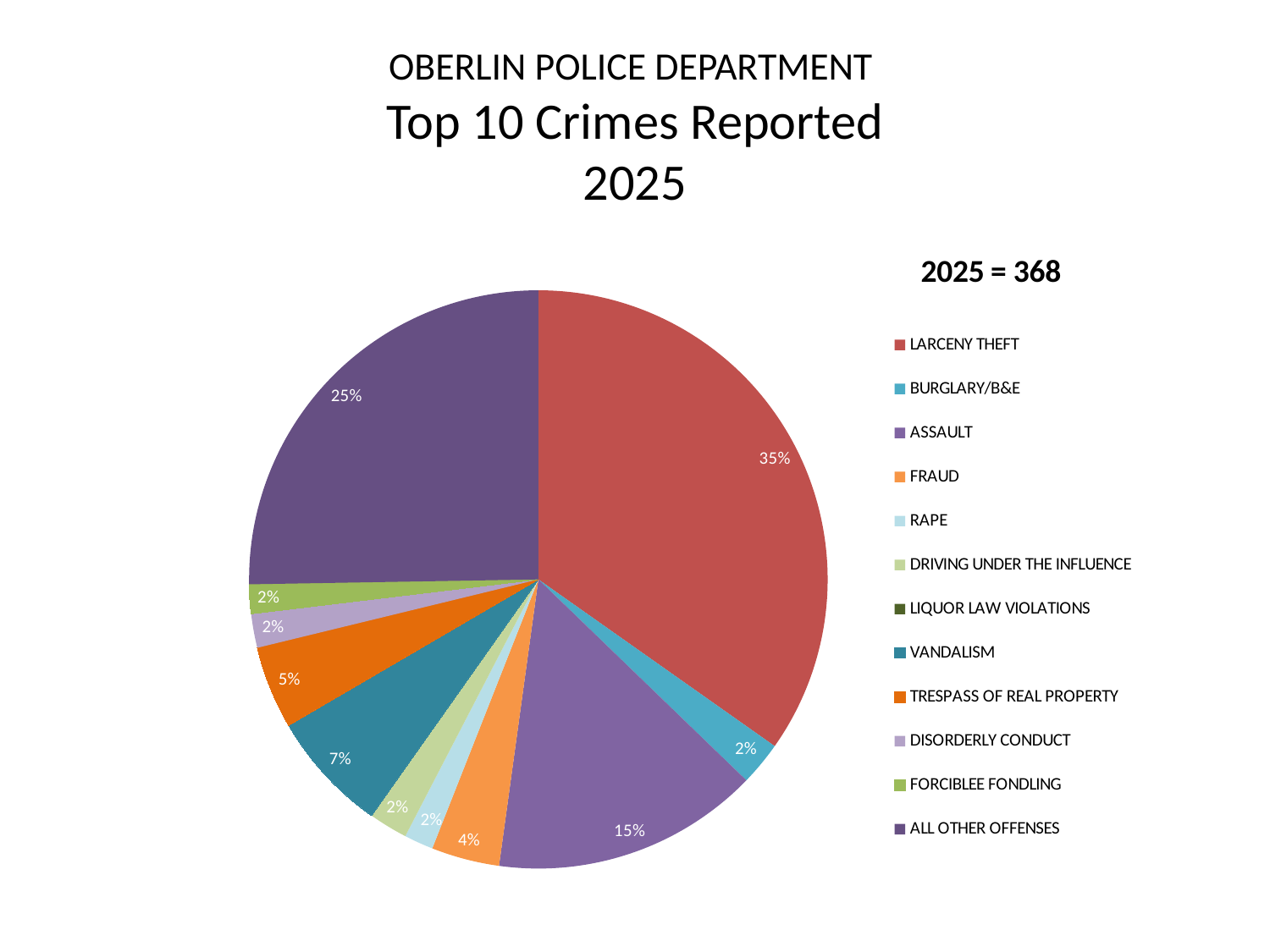
Which slice is larger, VANDALISM or TRESPASS OF REAL PROPERTY? VANDALISM What percentage is shown for ALL OTHER OFFENSES? 25% What total number of crimes for 2025 is stated next to the chart? 368 What percentage is shown for ASSAULT? 15% What percentage is shown for TRESPASS OF REAL PROPERTY? 5% What percentage is shown for FRAUD? 4% Which category has the largest slice of the pie? LARCENY THEFT How many percentage points larger is the LARCENY THEFT slice than the ASSAULT slice? 20 percentage points What percentage is shown for VANDALISM? 7% What share of the pie does LARCENY THEFT account for? 35% What kind of chart is shown on the slide? Pie chart How many categories does the legend list? 12